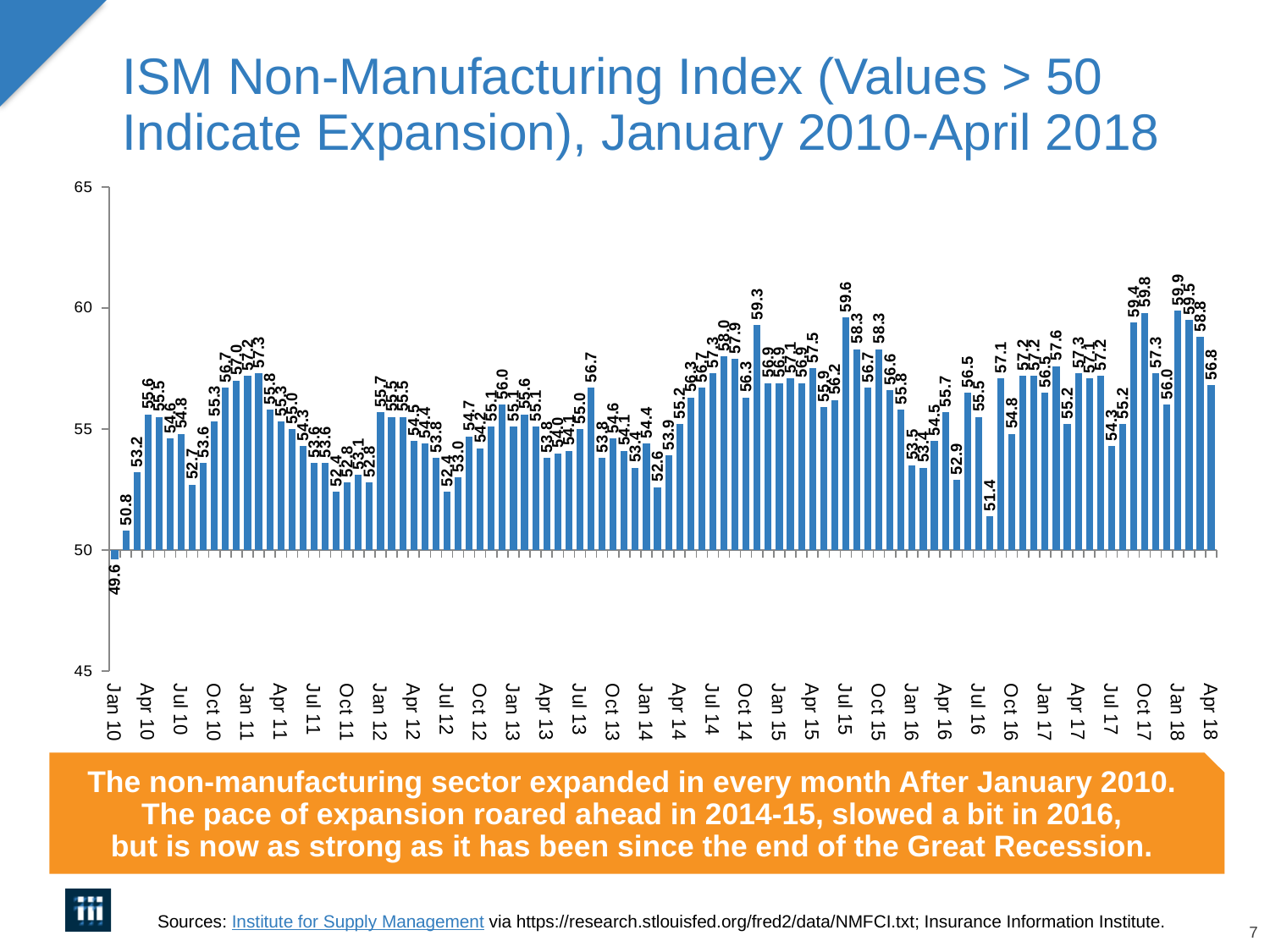
Do the values rise or fall from Jan 10 to Apr 10? rise What is the highest value shown on the chart? 59.9 Which is larger, the value for Jan 18 or the value for Apr 18? Jan 18 Is the value for Jan 10 greater or less than 50? less What type of chart is shown on the slide? bar chart What is the range of the vertical axis on the chart? 45 to 65 What is the difference between the highest value (59.9) and the lowest value (49.6) on the chart? 10.3 What is the lowest value shown on the chart? 49.6 What is the difference between the Jan 18 value and the Apr 18 value? 3.1 What is the ISM Non-Manufacturing Index value for Jan 10? 49.6 What is the ISM Non-Manufacturing Index value for Apr 18, the last bar on the chart? 56.8 What is the ISM Non-Manufacturing Index value for Jan 18? 59.9